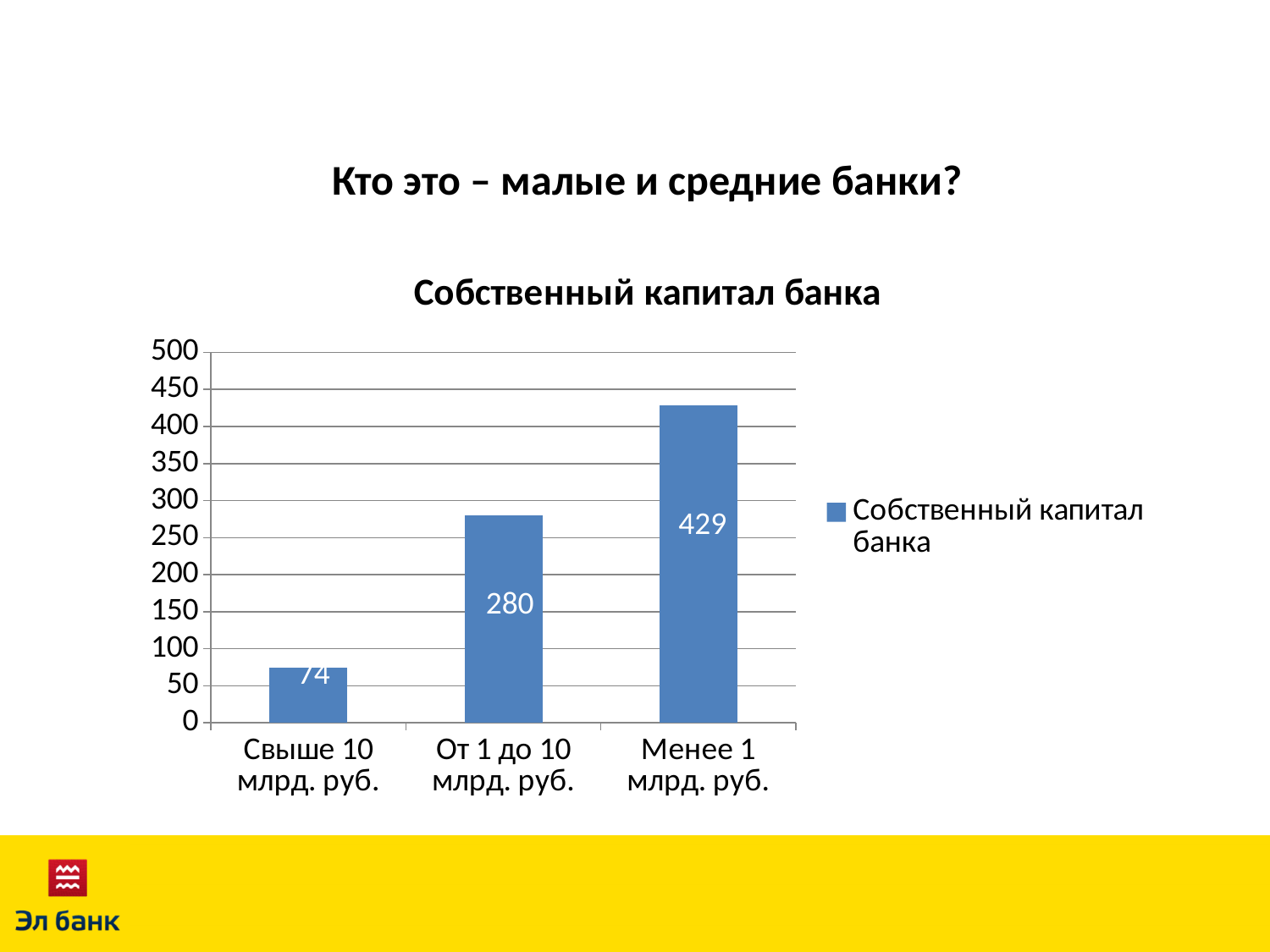
What is the difference between the values for "От 1 до 10 млрд. руб." and "Свыше 10 млрд. руб."? 206 What kind of chart is shown on the slide? bar chart Is the value for "Менее 1 млрд. руб." greater or less than 400? greater Which category has the highest value? Менее 1 млрд. руб. How many categories are shown on the x axis? 3 What is the value for "Свыше 10 млрд. руб."? 74 What is the difference between the values for "Менее 1 млрд. руб." and "От 1 до 10 млрд. руб."? 149 What is the value for "От 1 до 10 млрд. руб."? 280 Which is larger, the value for "От 1 до 10 млрд. руб." or the value for "Свыше 10 млрд. руб."? От 1 до 10 млрд. руб. Which category has the lowest value? Свыше 10 млрд. руб. What is the value for "Менее 1 млрд. руб."? 429 What is the title of the chart? Собственный капитал банка